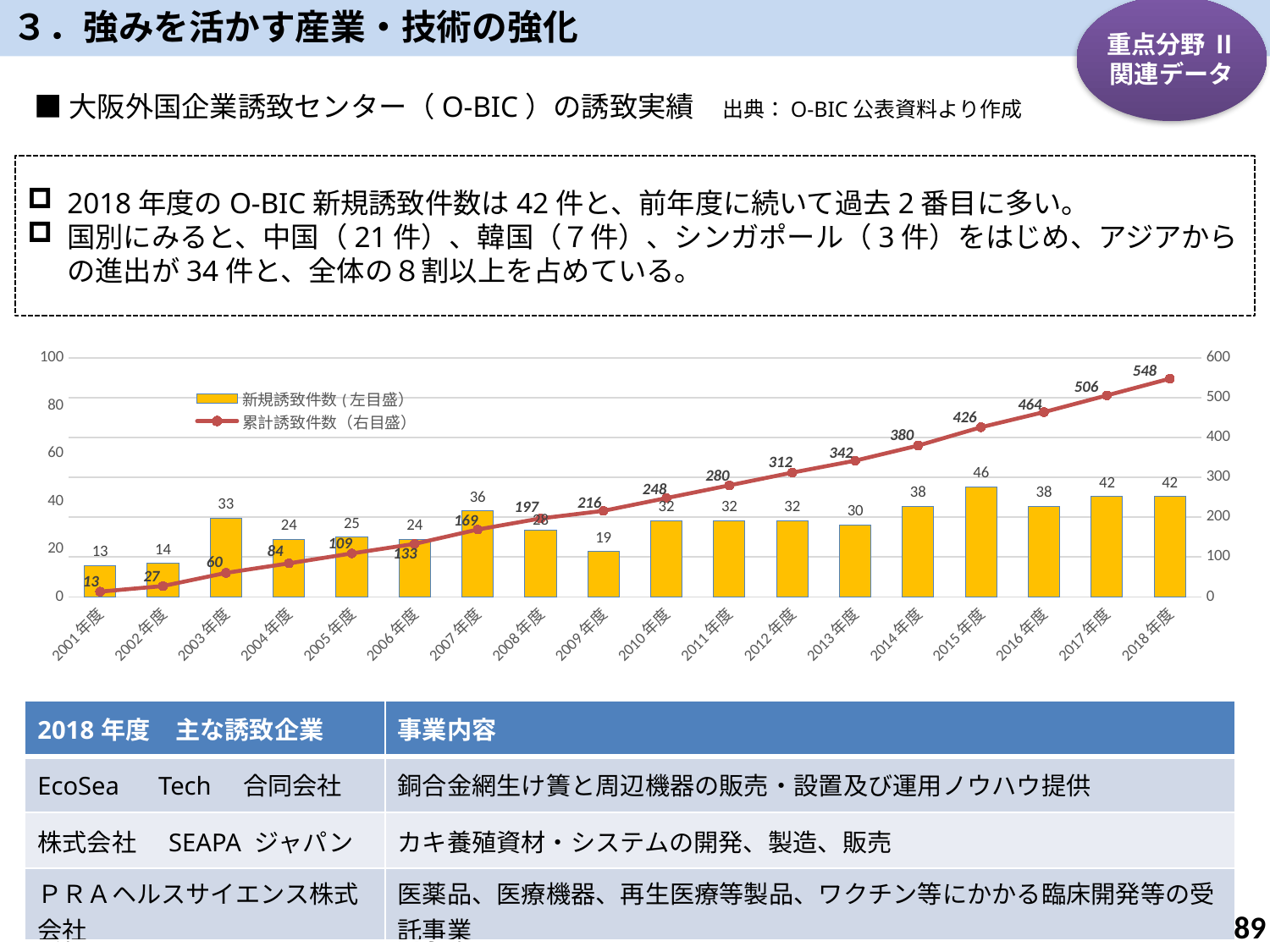
What is the value of 累計誘致件数 for 2018年度? 548 How many years are shown on the x axis of the chart? 18 Which year has the lowest 新規誘致件数? 2001年度 What is the value of 新規誘致件数 for 2009年度? 19 What is the difference in 新規誘致件数 between 2015年度 and 2014年度? 8 Does the 累計誘致件数 line rise or fall from 2001年度 to 2018年度? rise Which is larger, the 新規誘致件数 for 2003年度 or for 2004年度? 2003年度 How many series does the chart legend list? 2 What is the value of 新規誘致件数 for 2015年度? 46 Which series is plotted as a line in the chart? 累計誘致件数（右目盛） What is the difference in 累計誘致件数 between 2018年度 and 2017年度? 42 Which year has the highest 新規誘致件数? 2015年度